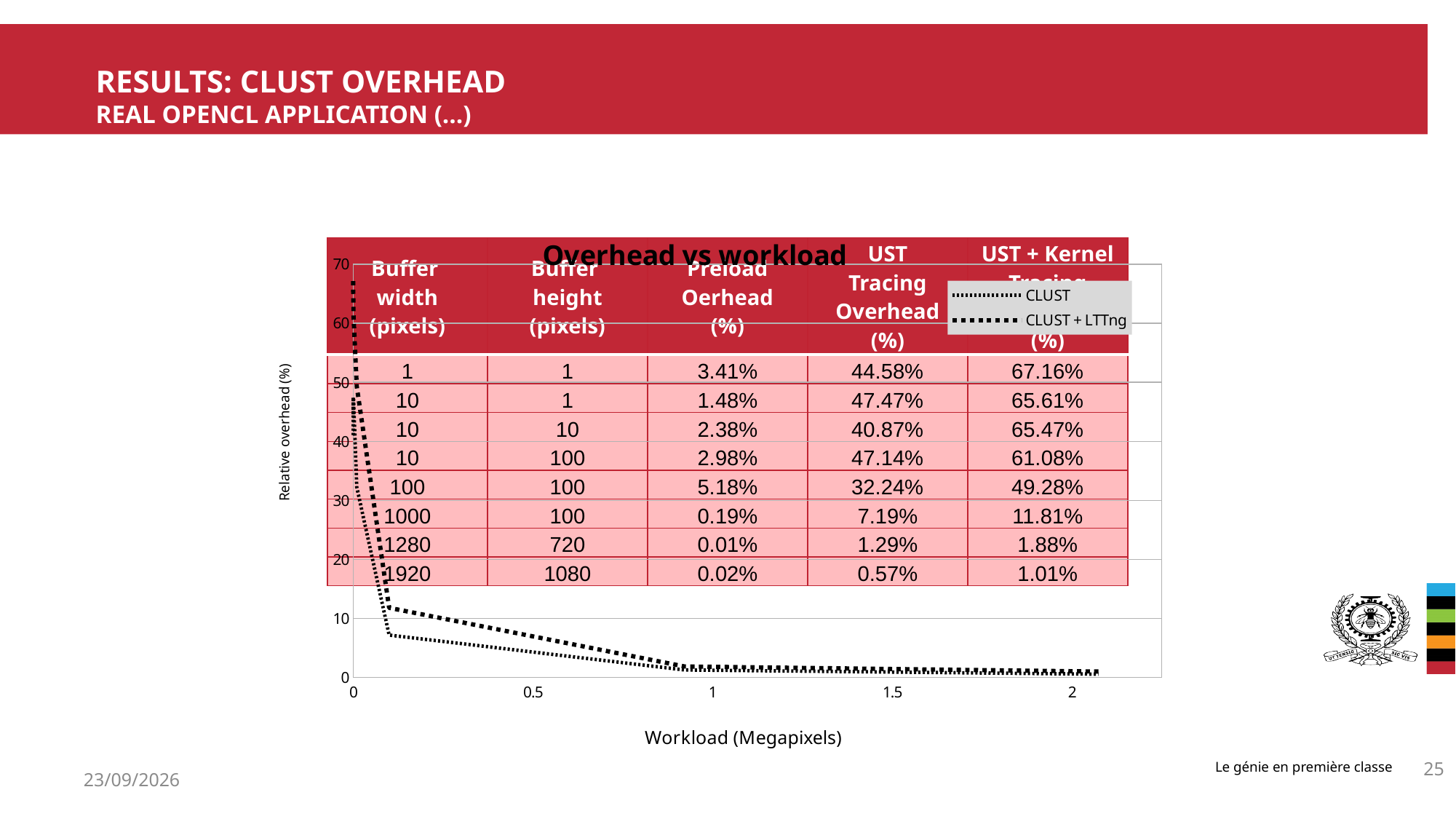
Is the relative overhead for CLUST + LTTng at a workload of 1.5 Megapixels greater or less than 10? less Is the relative overhead for CLUST + LTTng at a workload of 0 Megapixels greater or less than 50? greater Is the relative overhead for CLUST at a workload of 0.5 Megapixels greater or less than 20? less What is the label of the x axis of the chart? Workload (Megapixels) As workload increases along the x axis, do the relative overhead values rise or fall? fall What kind of chart is shown on the slide? line chart How many series does the chart legend list? 2 What is the title of the chart? Overhead vs workload At a workload of 0.5 Megapixels, which series has the higher relative overhead, CLUST or CLUST + LTTng? CLUST + LTTng What are the two series named in the chart legend? CLUST and CLUST + LTTng